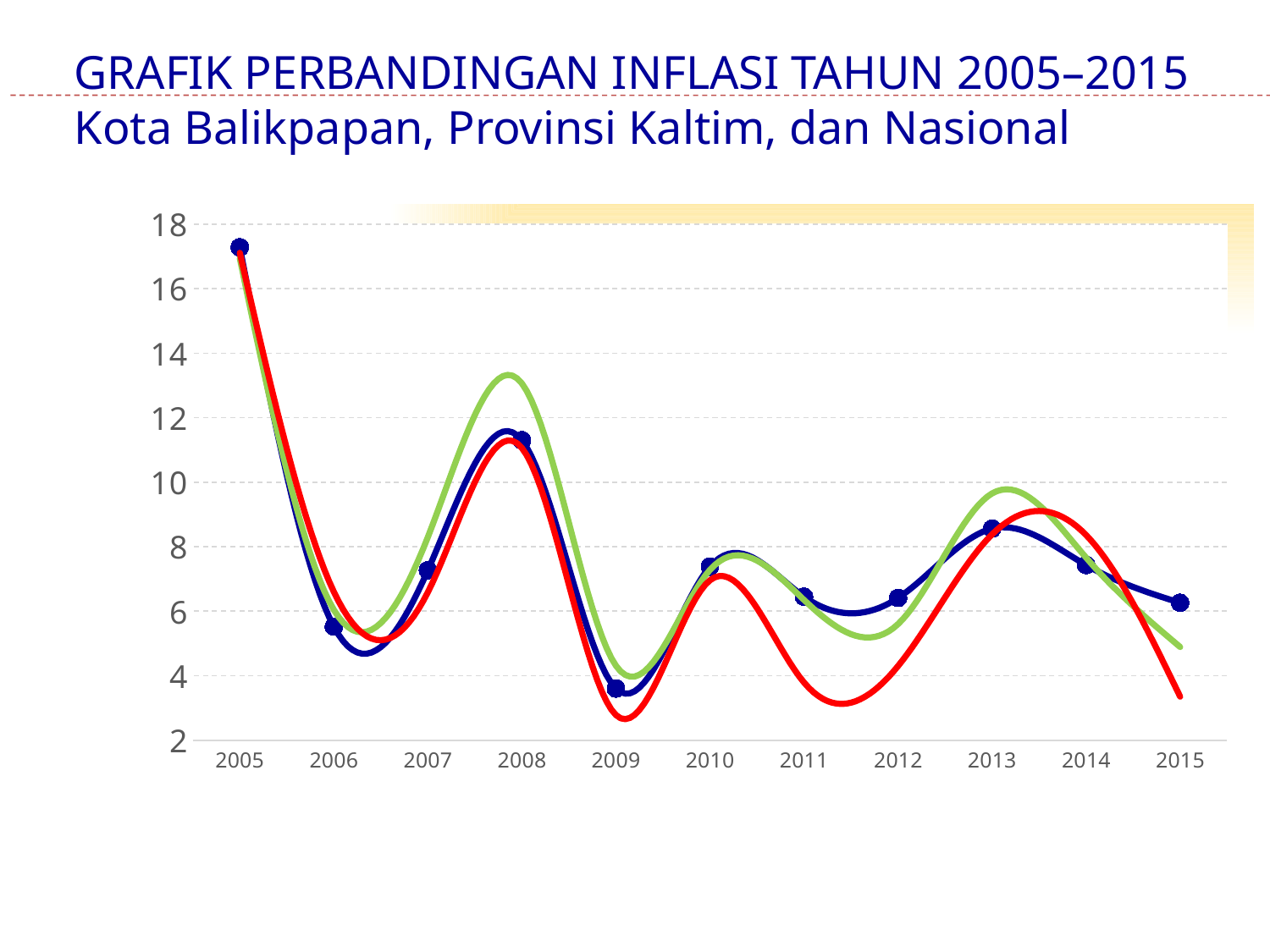
How many years are shown on the x axis of the chart? 11 How many lines are plotted on the chart? 3 Is the value of the blue line with markers in 2005 greater or less than 16? greater Is the value of the blue line with markers in 2009 greater or less than 4? less Is the peak of the green line in 2008 greater or less than 12? greater What kind of chart is shown on the slide? line chart In which year does the blue line with markers reach its highest value? 2005 What is the title of the chart on the slide? GRAFIK PERBANDINGAN INFLASI TAHUN 2005–2015 Kota Balikpapan, Provinsi Kaltim, dan Nasional In which year does the blue line with markers reach its lowest value? 2009 Which year has the larger value on the blue line with markers, 2005 or 2008? 2005 Does the blue line with markers rise or fall from 2013 to 2015? fall